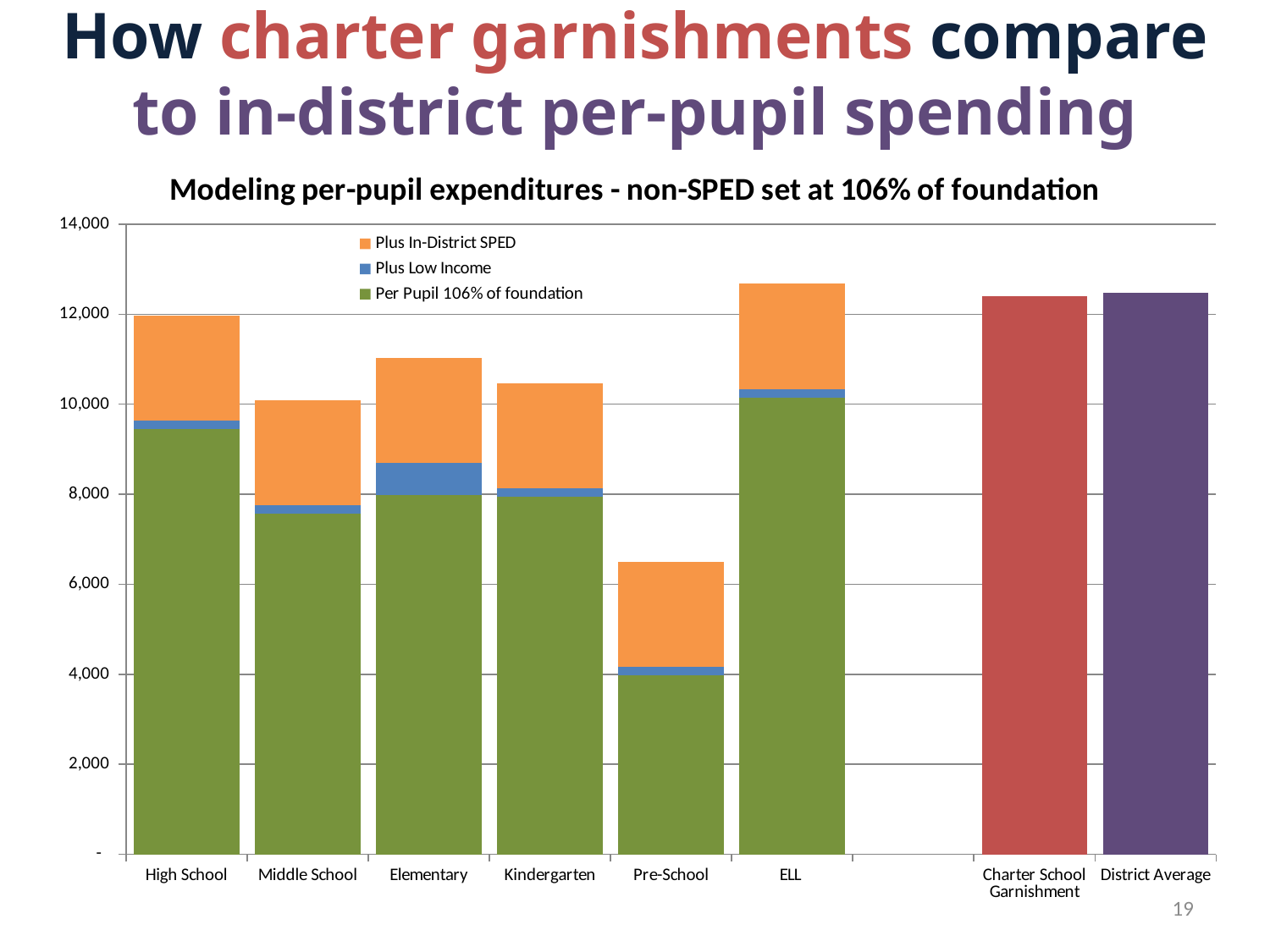
Among the stacked bars (High School through ELL), which category has the highest total? ELL Which category has the lowest total bar in the chart? Pre-School Is the value for Charter School Garnishment greater or less than 12,000? greater Which has the larger total bar, High School or Middle School? High School What kind of chart is shown on the slide? bar chart Is the total value for High School greater or less than 10,000? greater What is the title of the chart? Modeling per-pupil expenditures - non-SPED set at 106% of foundation Is the total value for Middle School greater or less than 12,000? less Which colour represents the Plus In-District SPED series in the chart? orange How many categories are labeled on the x axis of the chart? 8 How many series does the chart's legend list? 3